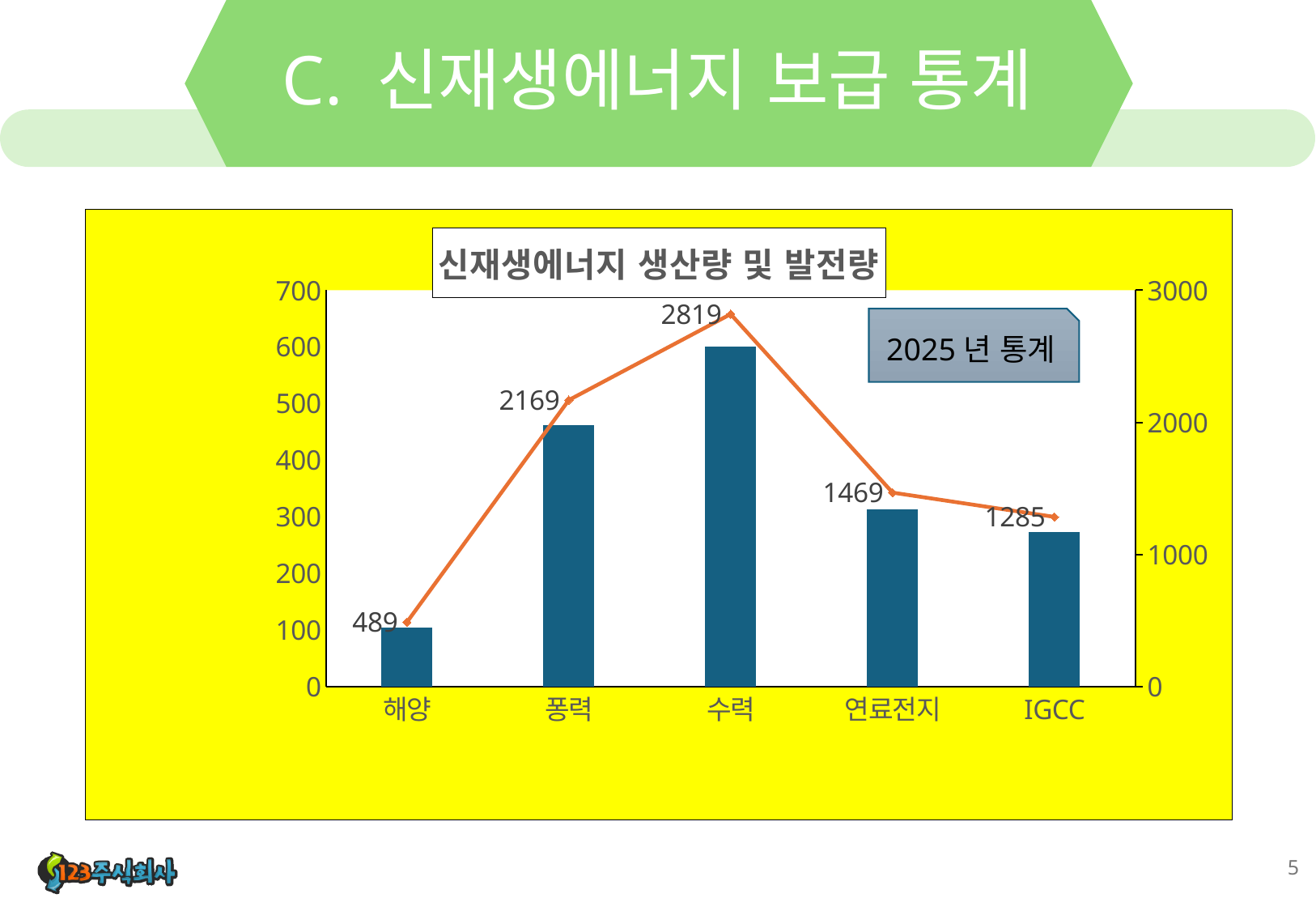
What is the line value labelled for 해양? 489 What is the line value labelled for IGCC? 1285 How many categories are shown on the x axis? 5 Which has a larger labelled line value, 연료전지 or IGCC? 연료전지 What kind of chart is shown? Combined bar and line chart Which category has the highest labelled line value? 수력 What is the title of the chart? 신재생에너지 생산량 및 발전량 Is the bar value for 수력 on the left axis greater or less than 500? greater Is the bar value for 해양 on the left axis greater or less than 200? less What is the difference between the labelled line values for 풍력 and 연료전지? 700 What is the line value labelled for 수력? 2819 Which category has the lowest labelled line value? 해양